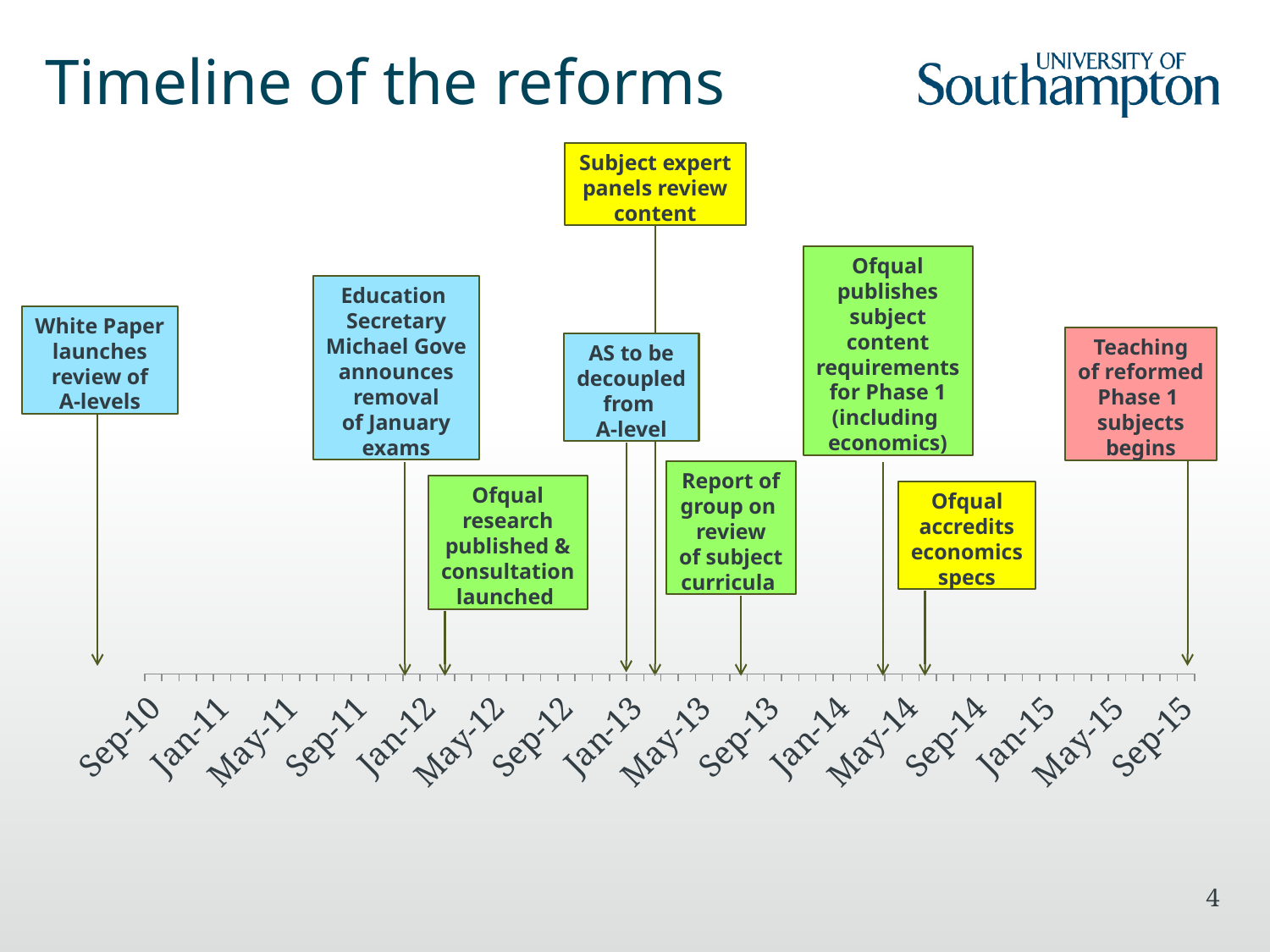
Which event is the latest on the timeline? Teaching of reformed Phase 1 subjects begins Which comes later on the timeline: 'White Paper launches review of A-levels' or 'Ofqual research published & consultation launched'? Ofqual research published & consultation launched What colour is the box for 'Teaching of reformed Phase 1 subjects begins'? Red/pink How many events are marked on the timeline? 9 Which comes first on the timeline: 'Ofqual accredits economics specs' or 'AS to be decoupled from A-level'? AS to be decoupled from A-level Which event is the earliest on the timeline? White Paper launches review of A-levels What is the first label on the timeline axis? Sep-10 Does the 'White Paper launches review of A-levels' event occur before or after Jan-11? before What is the last label on the timeline axis? Sep-15 Does the 'Teaching of reformed Phase 1 subjects begins' event occur before or after May-15? after What is the title of the slide? Timeline of the reforms What kind of chart is shown on the slide? Timeline